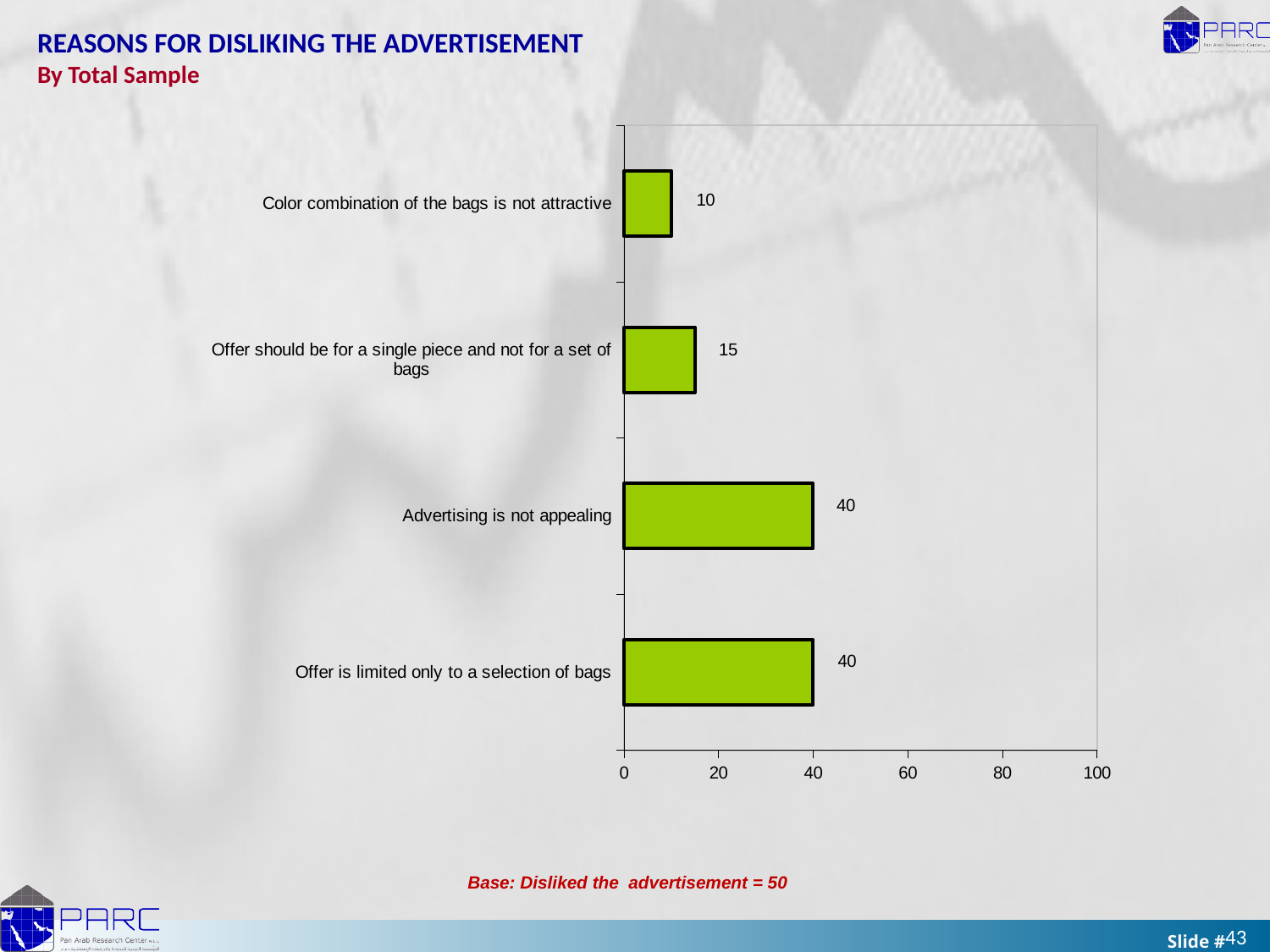
How many reasons are shown in the chart? 4 Which is larger: the value for "Offer is limited only to a selection of bags" or the value for "Offer should be for a single piece and not for a set of bags"? Offer is limited only to a selection of bags What is the base stated below the chart? Disliked the advertisement = 50 Is the value for "Advertising is not appealing" greater or less than 60? less What kind of chart is shown on the slide? bar chart What is the value for "Offer should be for a single piece and not for a set of bags"? 15 What is the difference between the values for "Advertising is not appealing" and "Color combination of the bags is not attractive"? 30 Which reason has the lowest value? Color combination of the bags is not attractive What is the value for "Offer is limited only to a selection of bags"? 40 What is the value for "Color combination of the bags is not attractive"? 10 What is the value for "Advertising is not appealing"? 40 What is the difference between the values for "Offer should be for a single piece and not for a set of bags" and "Color combination of the bags is not attractive"? 5